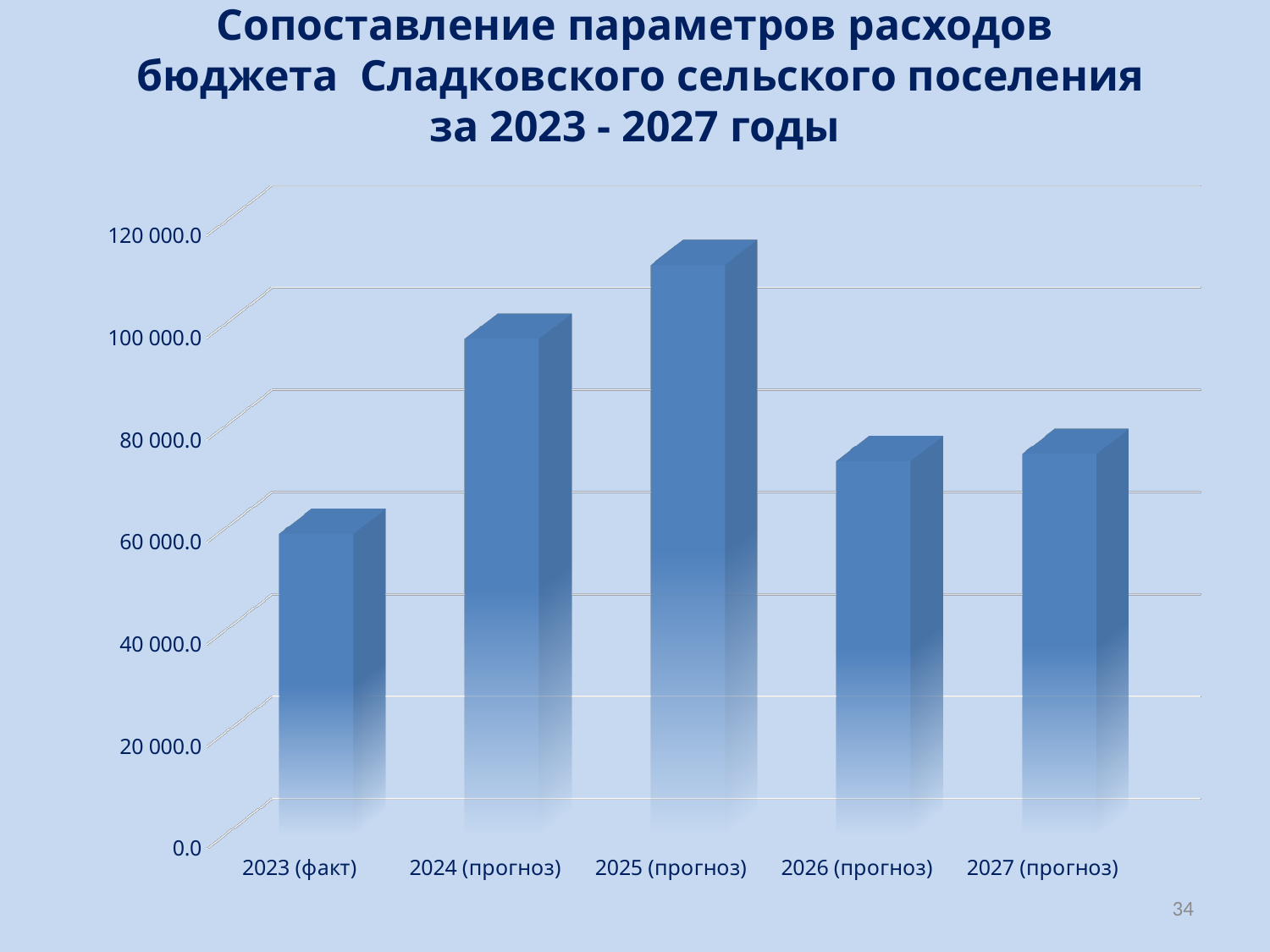
Which category has the highest value? 2025 (прогноз) Do the values rise or fall from 2023 (факт) to 2025 (прогноз)? rise How many categories (years) are shown on the x axis? 5 Which category has the lowest value? 2023 (факт) Which is larger, the value for 2023 (факт) or for 2024 (прогноз)? 2024 (прогноз) What is the title of the slide? Сопоставление параметров расходов бюджета Сладковского сельского поселения за 2023 - 2027 годы Is the value for 2026 (прогноз) greater or less than 80 000.0? less Is the value for 2023 (факт) greater or less than 40 000.0? greater Is the value for 2024 (прогноз) greater or less than 80 000.0? greater Which is larger, the value for 2025 (прогноз) or for 2026 (прогноз)? 2025 (прогноз) What kind of chart is shown on the slide? bar chart